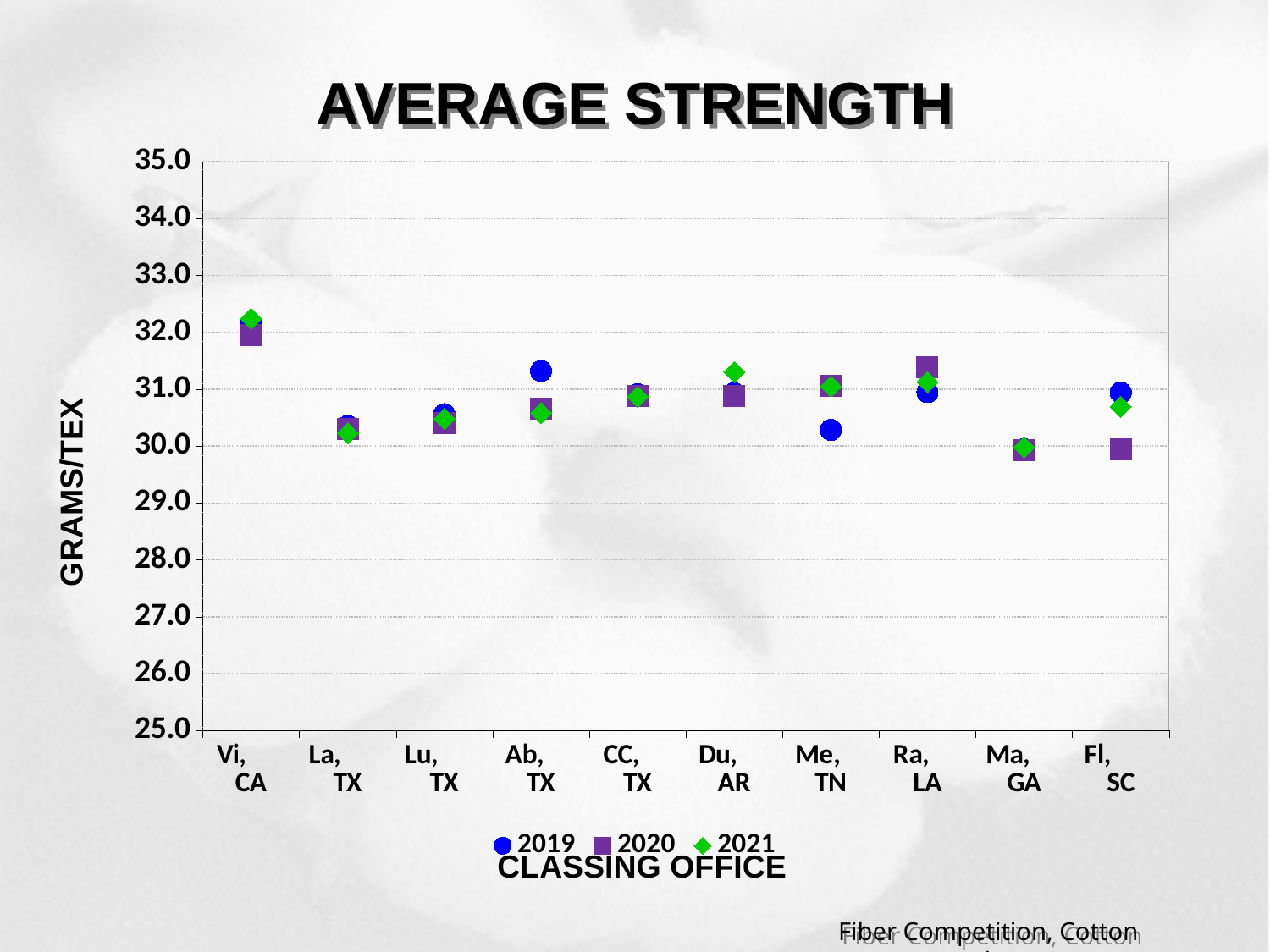
For Ab, TX, which series has the larger value, 2019 or 2020? 2019 What is the label of the vertical axis? GRAMS/TEX What kind of chart is shown on the slide? scatter chart Is the 2019 value for Ab, TX greater or less than 31.0? greater How many series does the legend list? 3 Is the 2019 value for Me, TN greater or less than 31.0? less Is the 2020 value for Fl, SC greater or less than 30.5? less Which classing office has the highest 2021 average strength? Vi, CA What is the title of the chart? AVERAGE STRENGTH How many classing offices are shown on the x axis? 10 For Me, TN, which series has the larger value, 2019 or 2020? 2020